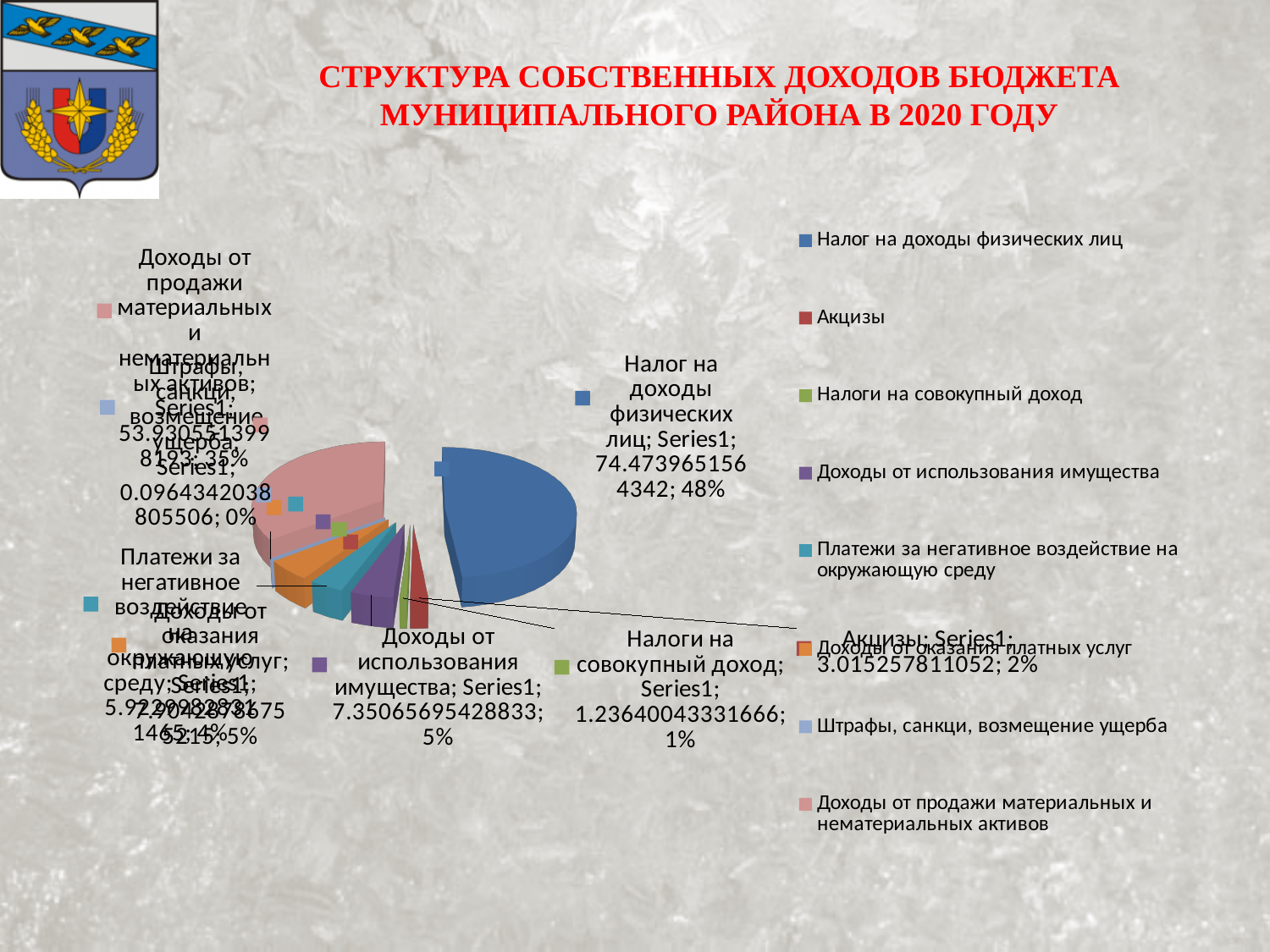
How many categories does the legend list? 8 What kind of chart is shown on the slide? pie chart What share of the pie does 'Доходы от использования имущества' represent? 5% What is the title of the slide containing the chart? СТРУКТУРА СОБСТВЕННЫХ ДОХОДОВ БЮДЖЕТА МУНИЦИПАЛЬНОГО РАЙОНА В 2020 ГОДУ What share of the pie does 'Налоги на совокупный доход' represent? 1% What share of the pie does 'Налог на доходы физических лиц' represent? 48% Which is larger: the share for 'Акцизы' or the share for 'Доходы от использования имущества'? Доходы от использования имущества Which category has the largest slice of the pie? Налог на доходы физических лиц Which category has the smallest slice of the pie? Штрафы, санкции, возмещение ущерба